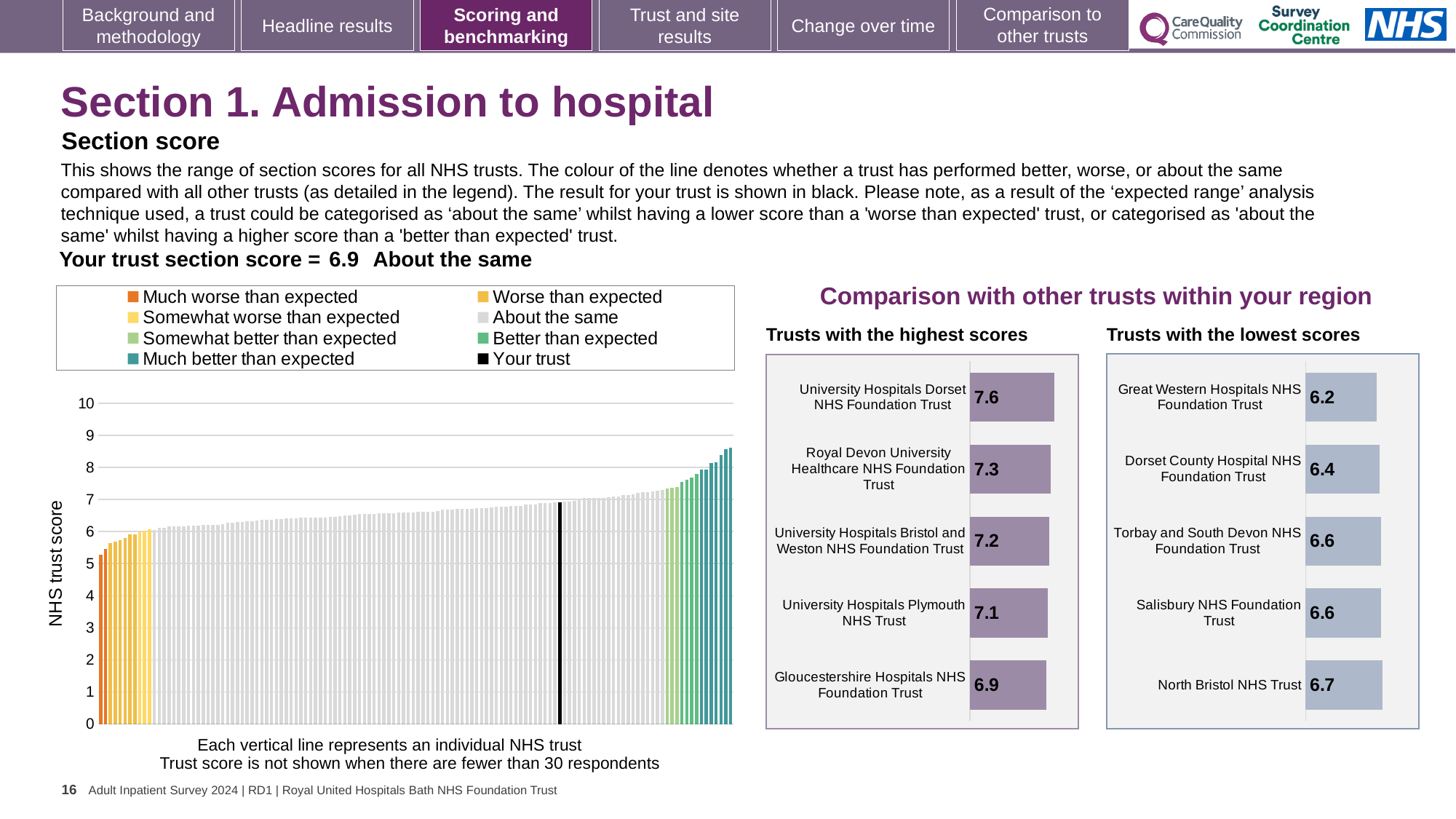
How many trusts are shown in the 'Trusts with the highest scores' chart? 5 In the 'Trusts with the lowest scores' chart, what is the difference between the scores of North Bristol NHS Trust and Great Western Hospitals NHS Foundation Trust? 0.5 What kind of chart is the main NHS trust score chart on the left? Bar chart In the 'Trusts with the lowest scores' chart, what is the score for North Bristol NHS Trust? 6.7 In the main NHS trust score chart on the left, do the trust scores rise or fall from left to right? Rise In the 'Trusts with the highest scores' chart, what is the difference between the scores of University Hospitals Dorset NHS Foundation Trust and Gloucestershire Hospitals NHS Foundation Trust? 0.7 In the main NHS trust score chart on the left, how many entries does the legend list? 8 In the 'Trusts with the lowest scores' chart, which trust has the lowest score? Great Western Hospitals NHS Foundation Trust In the main NHS trust score chart on the left, is the value of the highest bar greater or less than 8? greater In the 'Trusts with the highest scores' chart, what is the score for Gloucestershire Hospitals NHS Foundation Trust? 6.9 In the 'Trusts with the highest scores' chart, what is the score for University Hospitals Dorset NHS Foundation Trust? 7.6 In the 'Trusts with the lowest scores' chart, which has the higher score: Dorset County Hospital NHS Foundation Trust or North Bristol NHS Trust? North Bristol NHS Trust